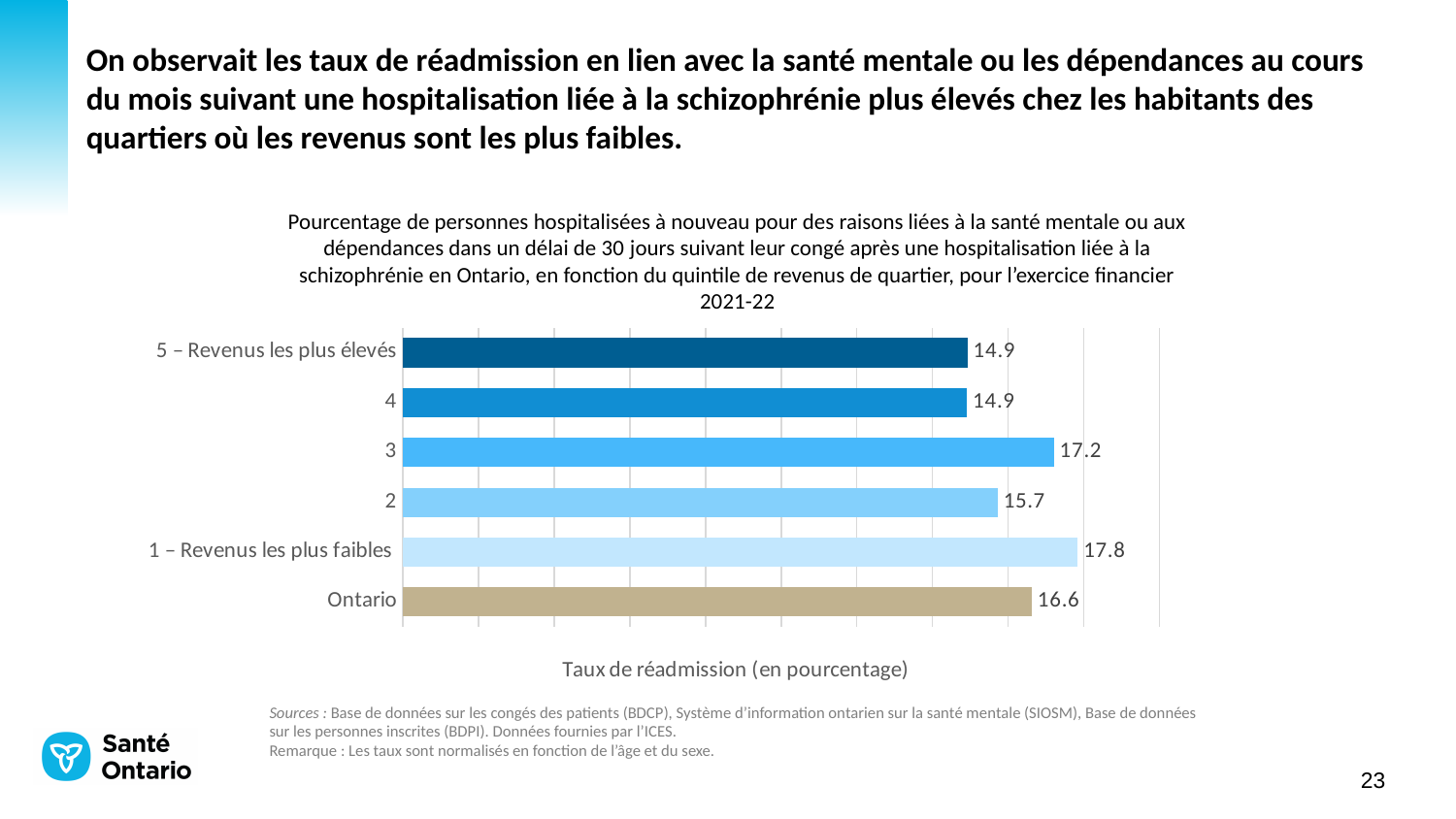
What is the difference between the value for quintile 3 and the value for quintile 2? 1.5 What is the value shown for quintile 5 – Revenus les plus élevés? 14.9 How many bars are shown in the chart? 6 What type of chart is shown on the slide? Bar chart What is the difference between the readmission rate for quintile 1 – Revenus les plus faibles and quintile 5 – Revenus les plus élevés? 2.9 What is the readmission rate for Ontario overall? 16.6 What is the title of the horizontal axis of the chart? Taux de réadmission (en pourcentage) Which is larger, the value for Ontario or the value for quintile 1 – Revenus les plus faibles? 1 – Revenus les plus faibles Which category has the highest readmission rate? 1 – Revenus les plus faibles What is the value shown for quintile 3? 17.2 Which has a higher readmission rate, quintile 3 or quintile 2? 3 What is the readmission rate for quintile 1 – Revenus les plus faibles? 17.8